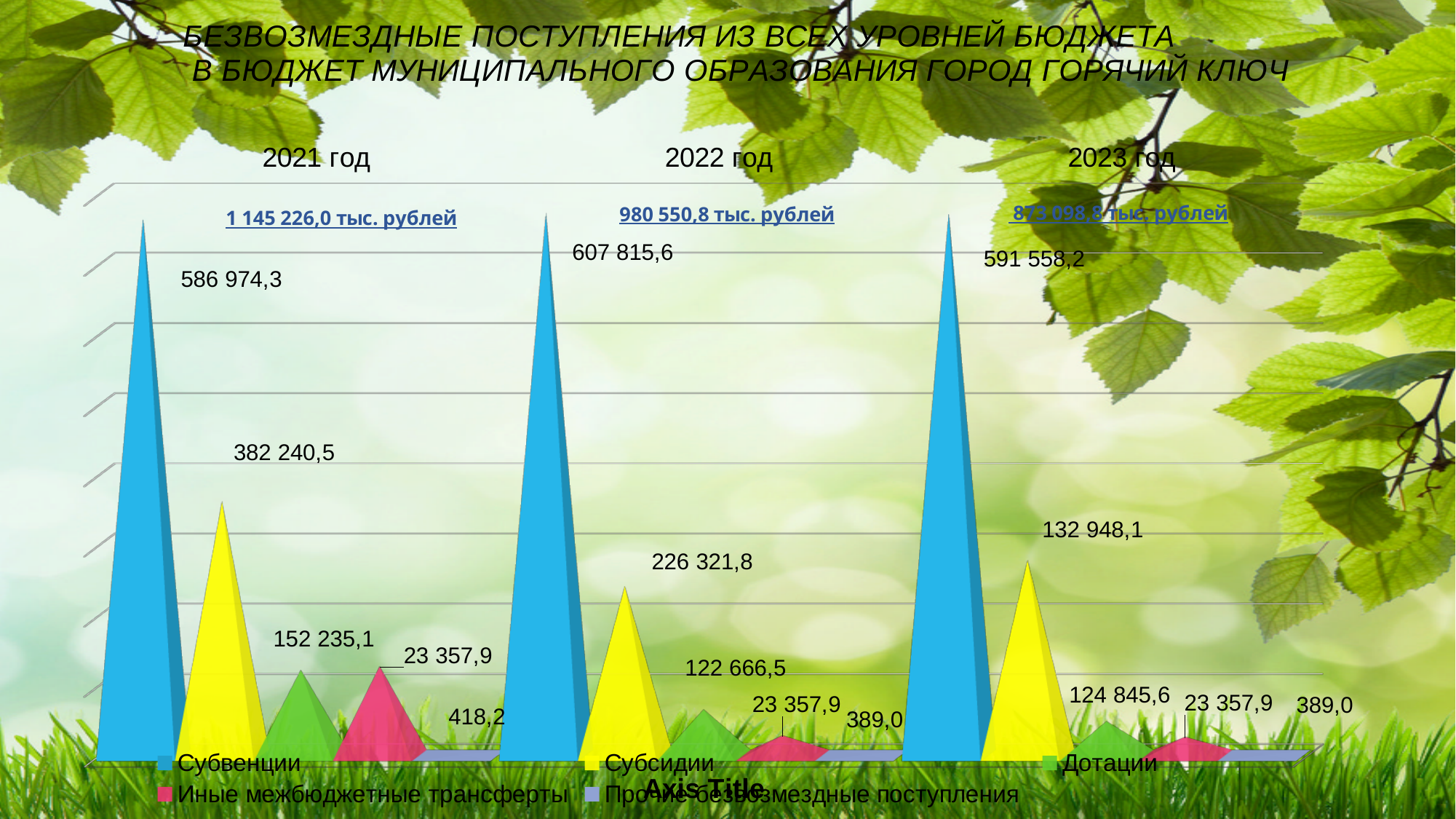
Which series has the lowest value in 2023 год? Прочие безвозмездные поступления How many series does the legend list? 5 What total is shown above the 2022 год group? 980 550,8 тыс. рублей What kind of chart is shown on the slide? Bar chart What is the value of Субсидии for 2022 год? 226 321,8 What is the value of Субвенции for 2021 год? 586 974,3 Which is larger: Дотации in 2021 год or Дотации in 2022 год? Дотации in 2021 год What is the difference between Субсидии in 2021 год and Субсидии in 2023 год? 249 292,4 What is the value of Прочие безвозмездные поступления for 2021 год? 418,2 Which series has the highest value in 2022 год? Субвенции What is the value of Дотации for 2023 год? 124 845,6 Do the values for Субсидии rise or fall from 2021 год to 2023 год? Fall